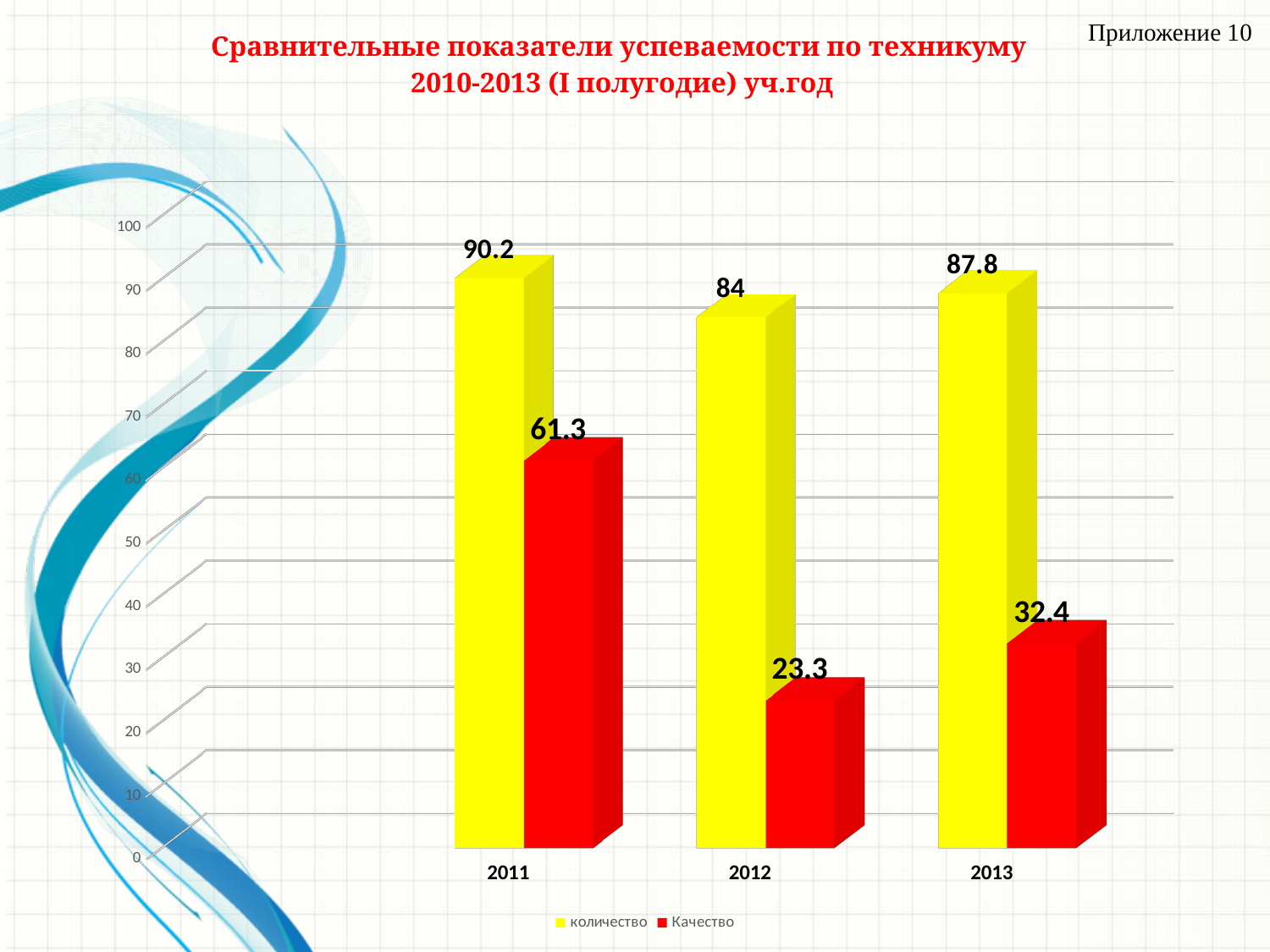
What is the value of Качество for 2013? 32.4 What is the value of количество for 2011? 90.2 What is the value of Качество for 2012? 23.3 Which colour represents the Качество series? Red What is the difference between the количество and Качество values for 2013? 55.4 What is the value of количество for 2012? 84 How many years are shown on the x axis? 3 Which year has the lowest количество value? 2012 Which year has the highest Качество value? 2011 How many series does the legend list? 2 Which is larger: Качество for 2012 or Качество for 2013? Качество for 2013 What kind of chart is shown on the slide? Bar chart